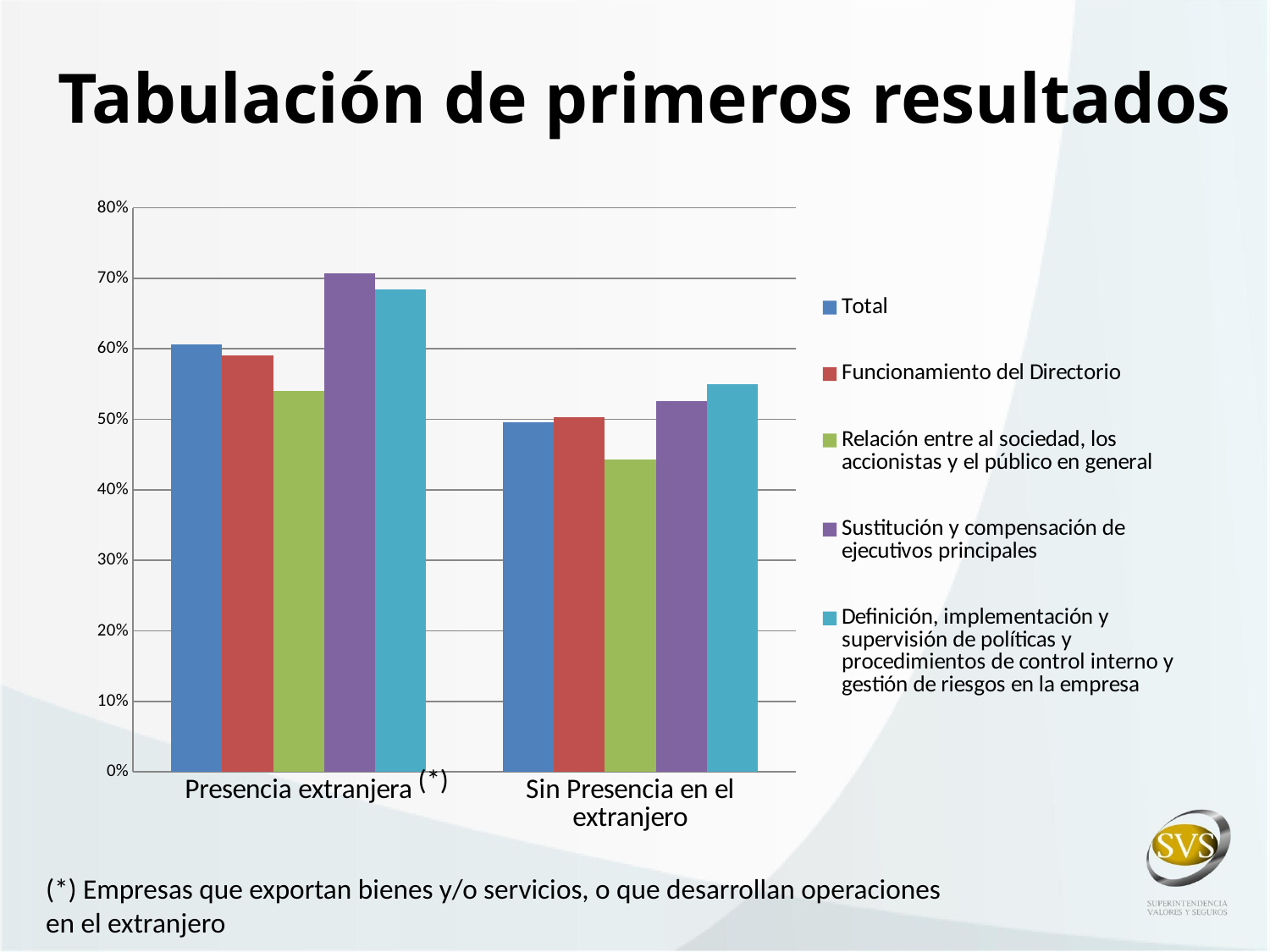
Which series has the lowest value in the Presencia extranjera category? Relación entre al sociedad, los accionistas y el público en general Is the Total value for Presencia extranjera greater or less than 50%? greater Is the value for Definición, implementación y supervisión de políticas y procedimientos de control interno y gestión de riesgos en la empresa in the Sin Presencia en el extranjero category greater or less than 50%? greater Is the value for Relación entre al sociedad, los accionistas y el público en general in the Sin Presencia en el extranjero category greater or less than 50%? less Which series has the highest value in the Presencia extranjera category? Sustitución y compensación de ejecutivos principales How many categories are shown on the x axis? 2 Which series has the lowest value in the Sin Presencia en el extranjero category? Relación entre al sociedad, los accionistas y el público en general For the Total series, which category has the larger value: Presencia extranjera or Sin Presencia en el extranjero? Presencia extranjera How many series does the legend list? 5 What kind of chart is shown on the slide? Bar chart Do the values for each series rise or fall from Presencia extranjera to Sin Presencia en el extranjero? Fall